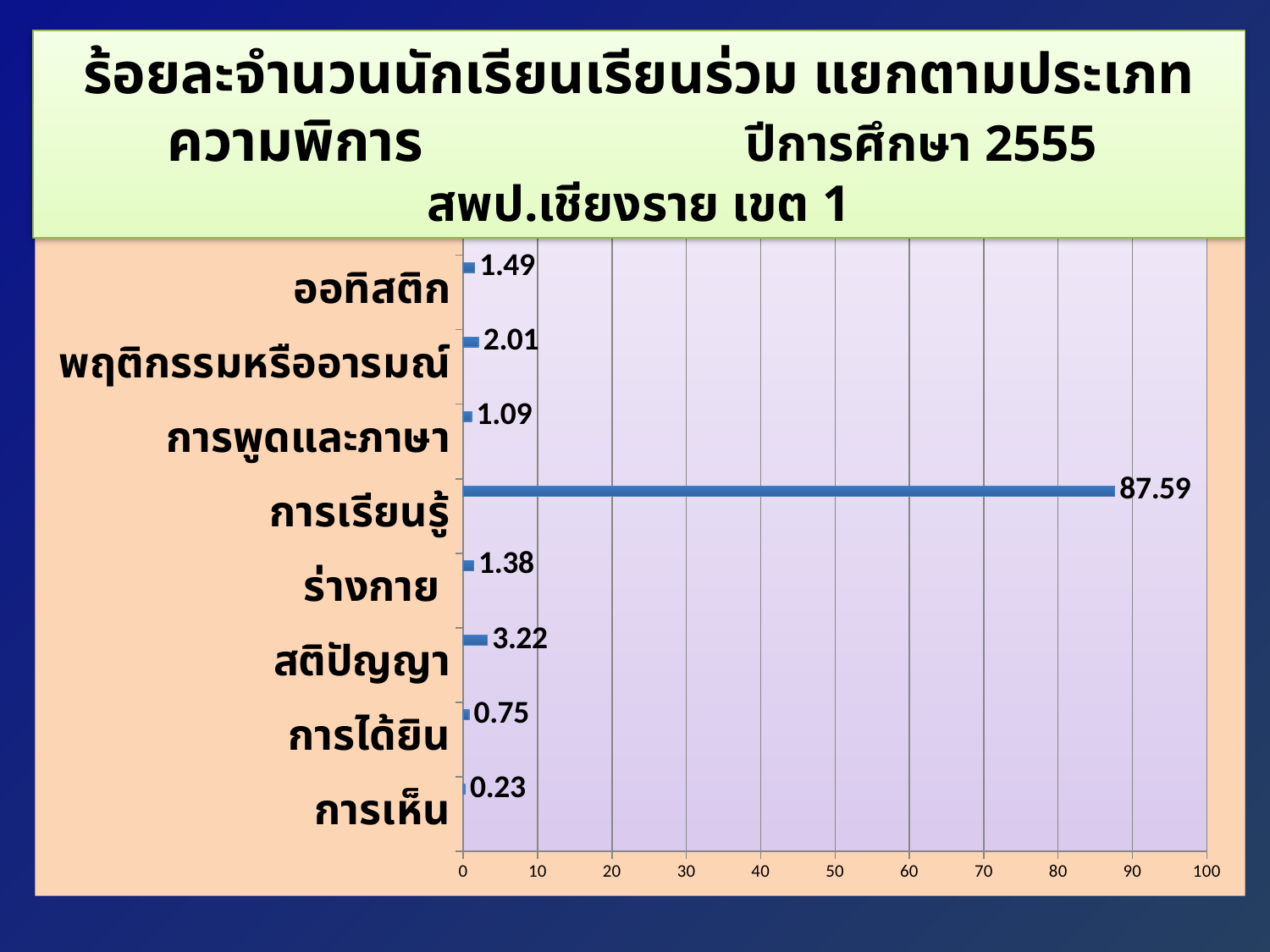
What type of chart is shown on the slide? bar chart What is the value for สติปัญญา? 3.22 Which academic year (ปีการศึกษา) does the chart title refer to? 2555 Which category has the lowest value? การเห็น Which is larger, the value for พฤติกรรมหรืออารมณ์ or the value for การพูดและภาษา? พฤติกรรมหรืออารมณ์ What is the value for การเรียนรู้? 87.59 What is the value for การได้ยิน? 0.75 How many disability categories are plotted in the chart? 8 Is the value for การเรียนรู้ greater or less than 80? greater What is the difference between the values for สติปัญญา and ร่างกาย? 1.84 What is the value for ออทิสติก? 1.49 Which category has the highest value? การเรียนรู้